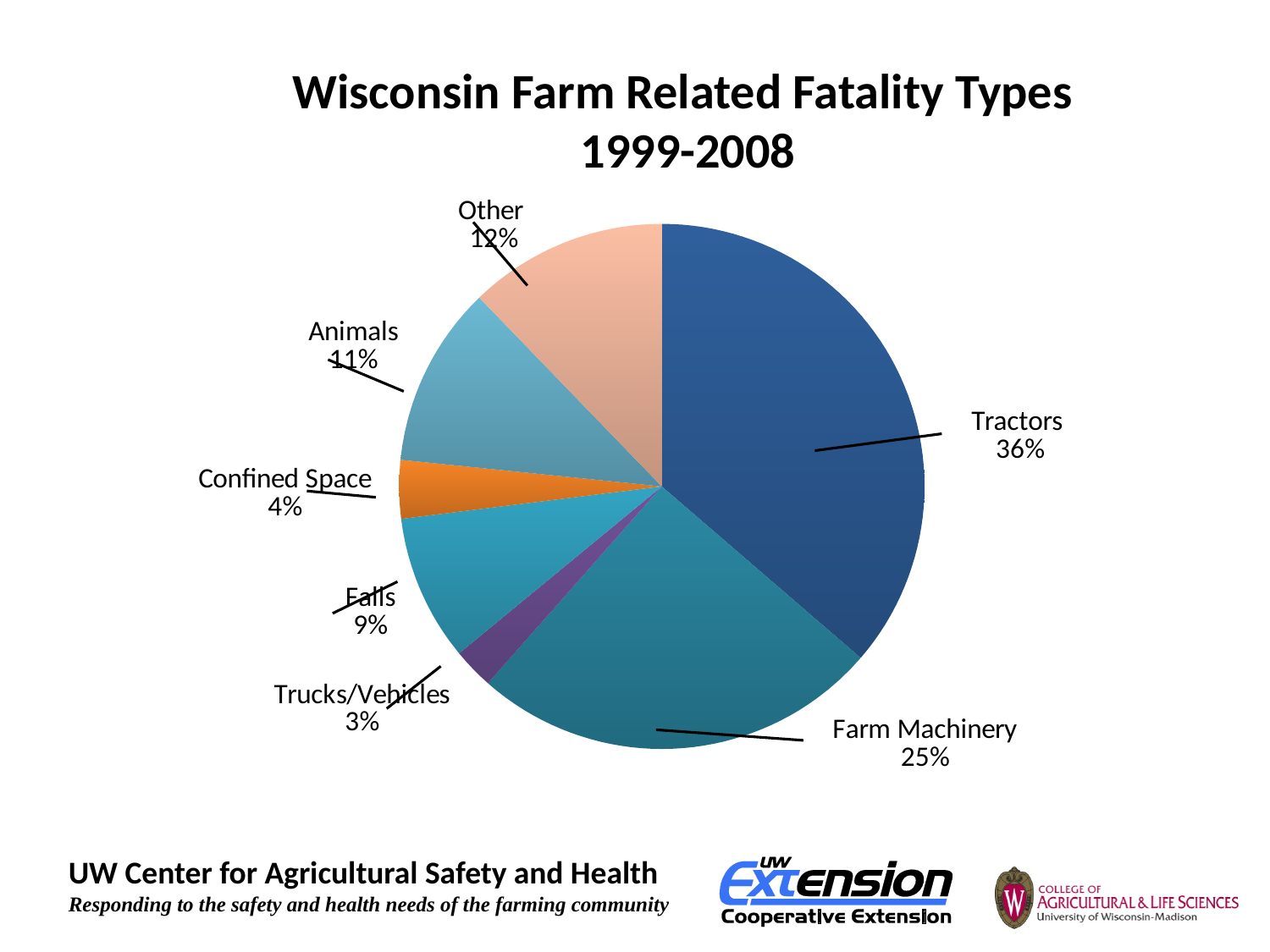
What is the combined share of Other and Animals? 23% What is the value shown for Confined Space? 4% What is the difference in percentage points between Tractors and Farm Machinery? 11 Which fatality type has the largest share of the pie? Tractors What is the title of the chart? Wisconsin Farm Related Fatality Types 1999-2008 How many fatality types are shown in the pie chart? 7 What percentage is shown for Trucks/Vehicles? 3% What percentage of fatalities is shown for Farm Machinery? 25% Which fatality type has the smallest share of the pie? Trucks/Vehicles What kind of chart is shown on the slide? Pie chart Which has a larger share, Animals or Falls? Animals What share of Wisconsin farm related fatalities is attributed to Tractors? 36%